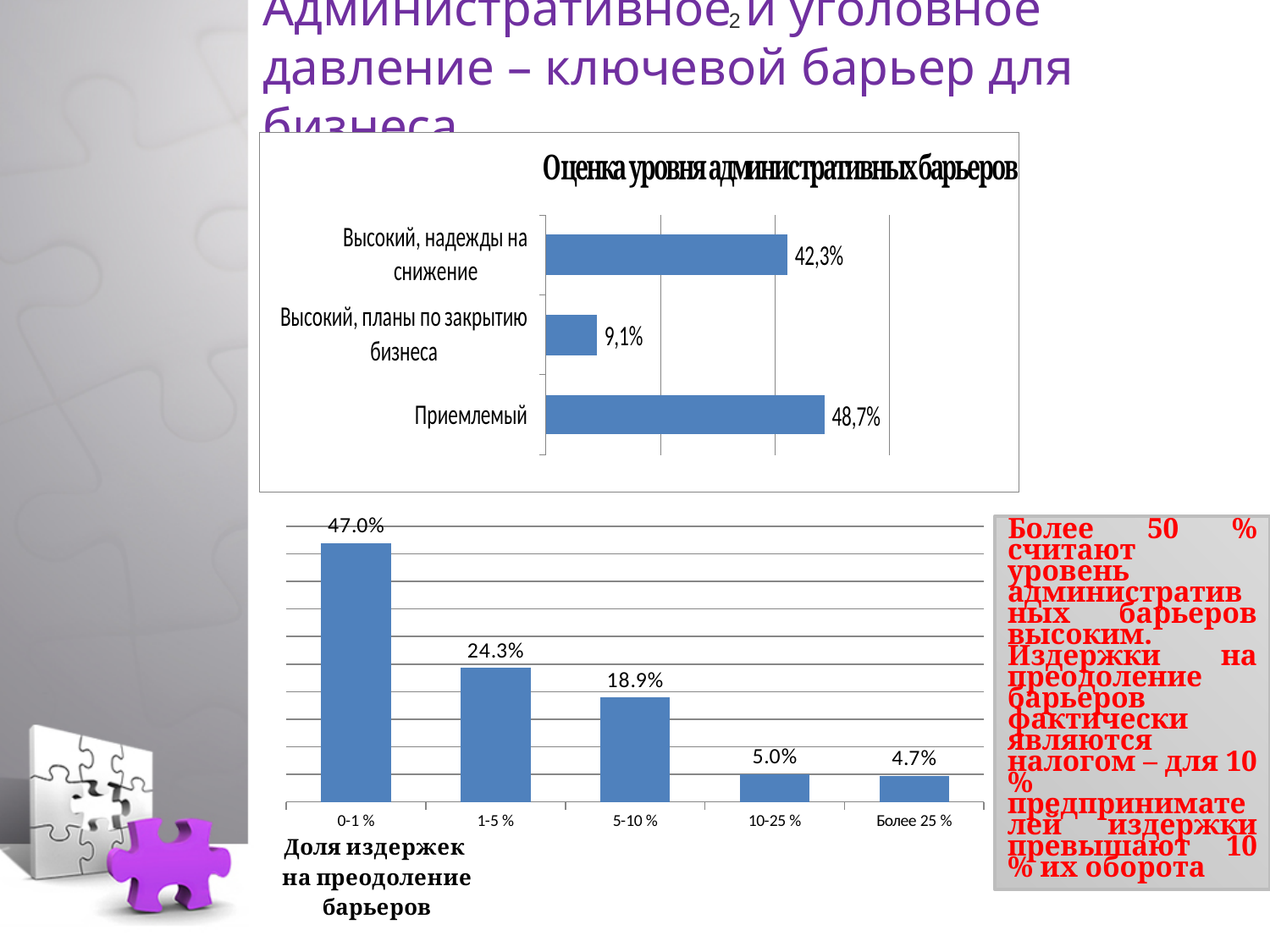
In the top chart 'Оценка уровня административных барьеров', which category has the lowest value? Высокий, планы по закрытию бизнеса In the top chart 'Оценка уровня административных барьеров', what is the difference between 'Приемлемый' and 'Высокий, надежды на снижение'? 6,4% In the bottom chart 'Доля издержек на преодоление барьеров', what is the value for 'Более 25 %'? 4.7% In the top chart 'Оценка уровня административных барьеров', what is the value for 'Приемлемый'? 48,7% In the bottom chart 'Доля издержек на преодоление барьеров', which category has the highest value? 0-1 % In the bottom chart 'Доля издержек на преодоление барьеров', do the values rise or fall from left to right along the x axis? Fall In the top chart 'Оценка уровня административных барьеров', what is the value for 'Высокий, планы по закрытию бизнеса'? 9,1% In the bottom chart 'Доля издержек на преодоление барьеров', what is the value for '1-5 %'? 24.3% In the top chart 'Оценка уровня административных барьеров', how many categories are shown? 3 In the top chart 'Оценка уровня административных барьеров', which category has the highest value? Приемлемый What type of chart is the top chart 'Оценка уровня административных барьеров'? Bar chart In the bottom chart 'Доля издержек на преодоление барьеров', how many categories are shown on the x axis? 5